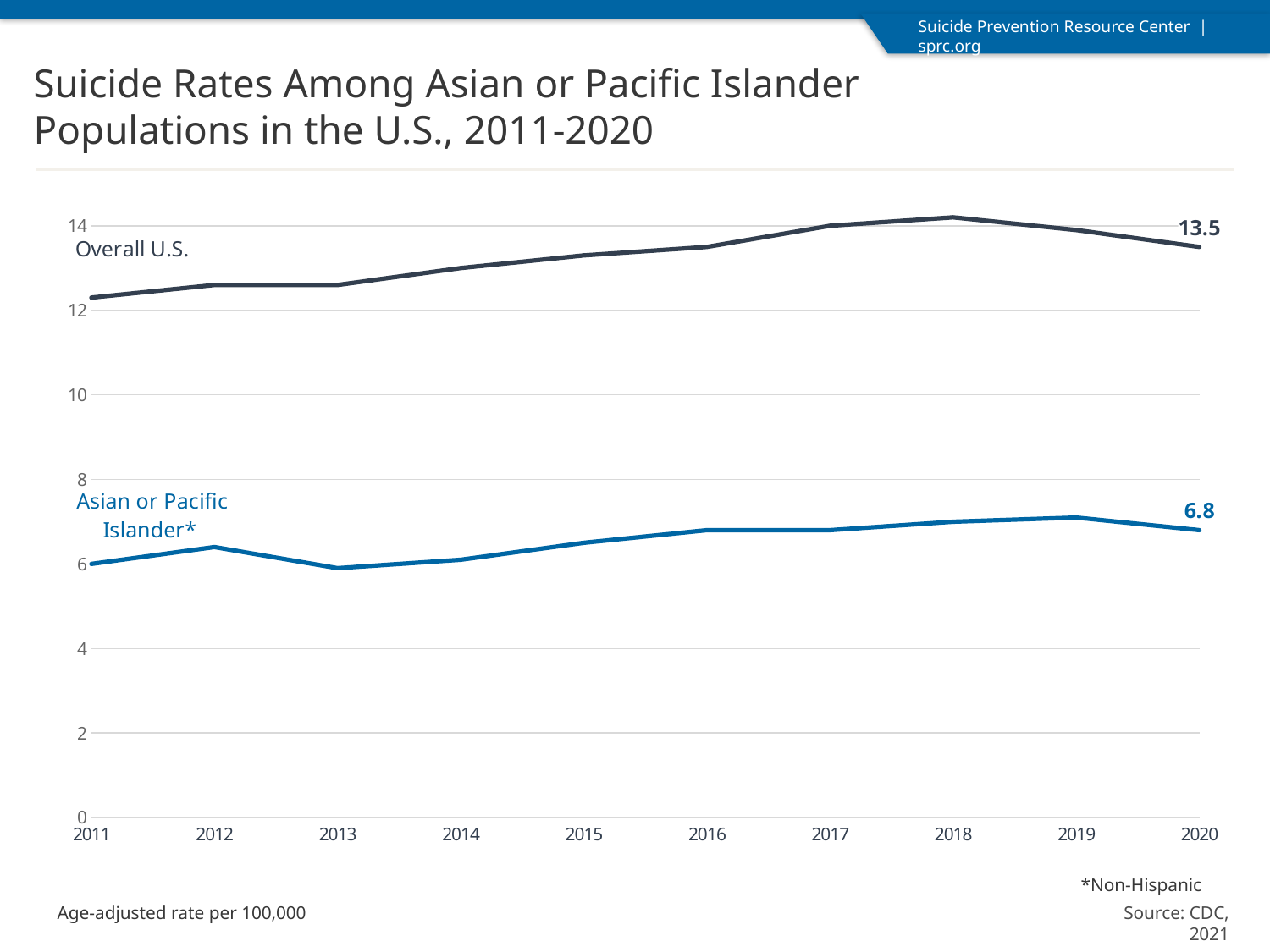
Is the Asian or Pacific Islander rate in 2013 greater or less than 8? less In which year does the Overall U.S. series reach its highest value? 2018 What kind of chart is shown on the slide? line chart What is the Asian or Pacific Islander suicide rate shown for 2020? 6.8 Does the Overall U.S. rate rise or fall from 2011 to 2018? rise Is the Asian or Pacific Islander rate in 2016 greater or less than 6? greater How many series are plotted on the chart? 2 Is the Overall U.S. rate in 2011 greater or less than 12? greater How many years are plotted on the x axis? 10 In 2020, which series has the higher rate: Overall U.S. or Asian or Pacific Islander? Overall U.S. What is the difference between the Overall U.S. rate and the Asian or Pacific Islander rate in 2020? 6.7 What is the Overall U.S. suicide rate shown for 2020? 13.5